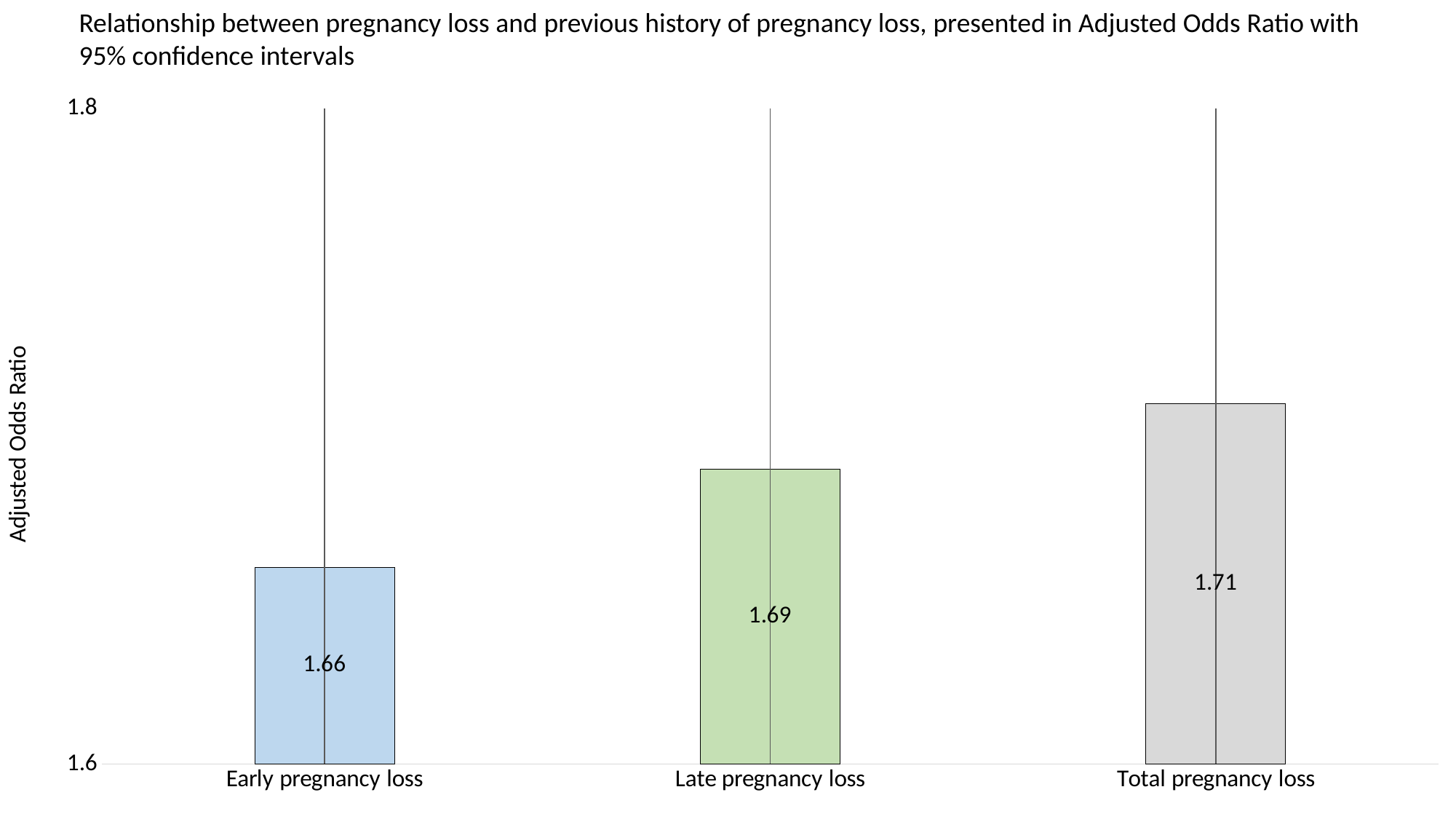
How many categories are shown on the x axis? 3 What is the adjusted odds ratio for Late pregnancy loss? 1.69 What kind of chart is shown on the slide? Bar chart Which category has the lowest adjusted odds ratio? Early pregnancy loss What is the difference between the adjusted odds ratios for Late pregnancy loss and Early pregnancy loss? 0.03 Which is larger, the adjusted odds ratio for Late pregnancy loss or for Early pregnancy loss? Late pregnancy loss What is the difference between the adjusted odds ratios for Total pregnancy loss and Early pregnancy loss? 0.05 What is the adjusted odds ratio for Total pregnancy loss? 1.71 What is the adjusted odds ratio for Early pregnancy loss? 1.66 Do the values rise or fall from left to right along the x axis? Rise What is the label of the vertical axis? Adjusted Odds Ratio Which category has the highest adjusted odds ratio? Total pregnancy loss